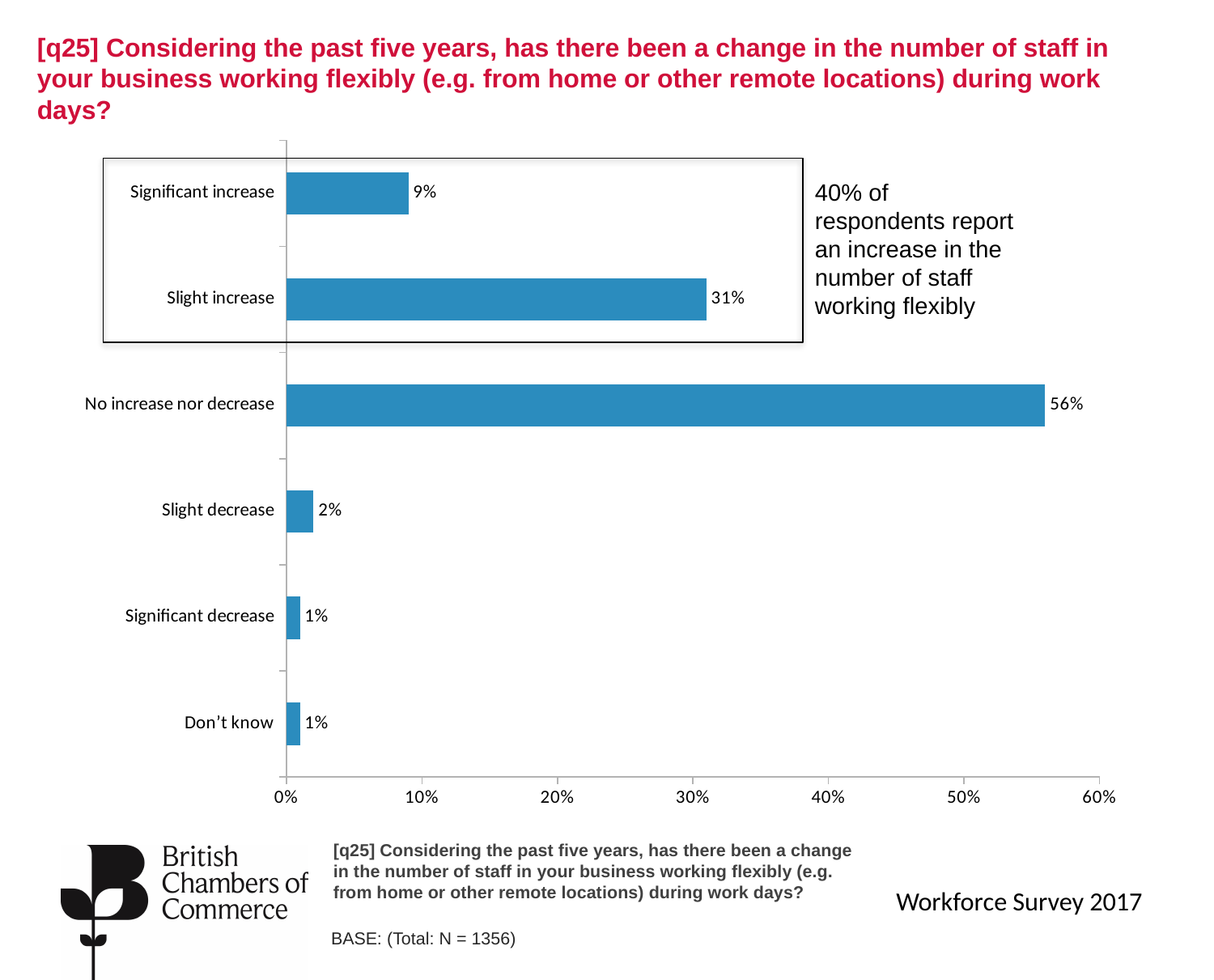
What kind of chart is shown on the slide? Bar chart Which is larger, the value for 'Slight decrease' or the value for 'Significant increase'? Significant increase According to the callout text, what percentage of respondents report an increase in the number of staff working flexibly? 40% What is the difference between 'No increase nor decrease' and 'Slight increase'? 25% How many categories are shown in the chart? 6 What is the difference between 'Slight increase' and 'Significant increase'? 22% What percentage of respondents answered 'Don't know'? 1% What is the value for 'No increase nor decrease'? 56% What percentage of respondents reported a significant increase in staff working flexibly? 9% What percentage of respondents reported a slight increase? 31% Is the value for 'No increase nor decrease' greater or less than 50%? greater Which category has the highest value? No increase nor decrease